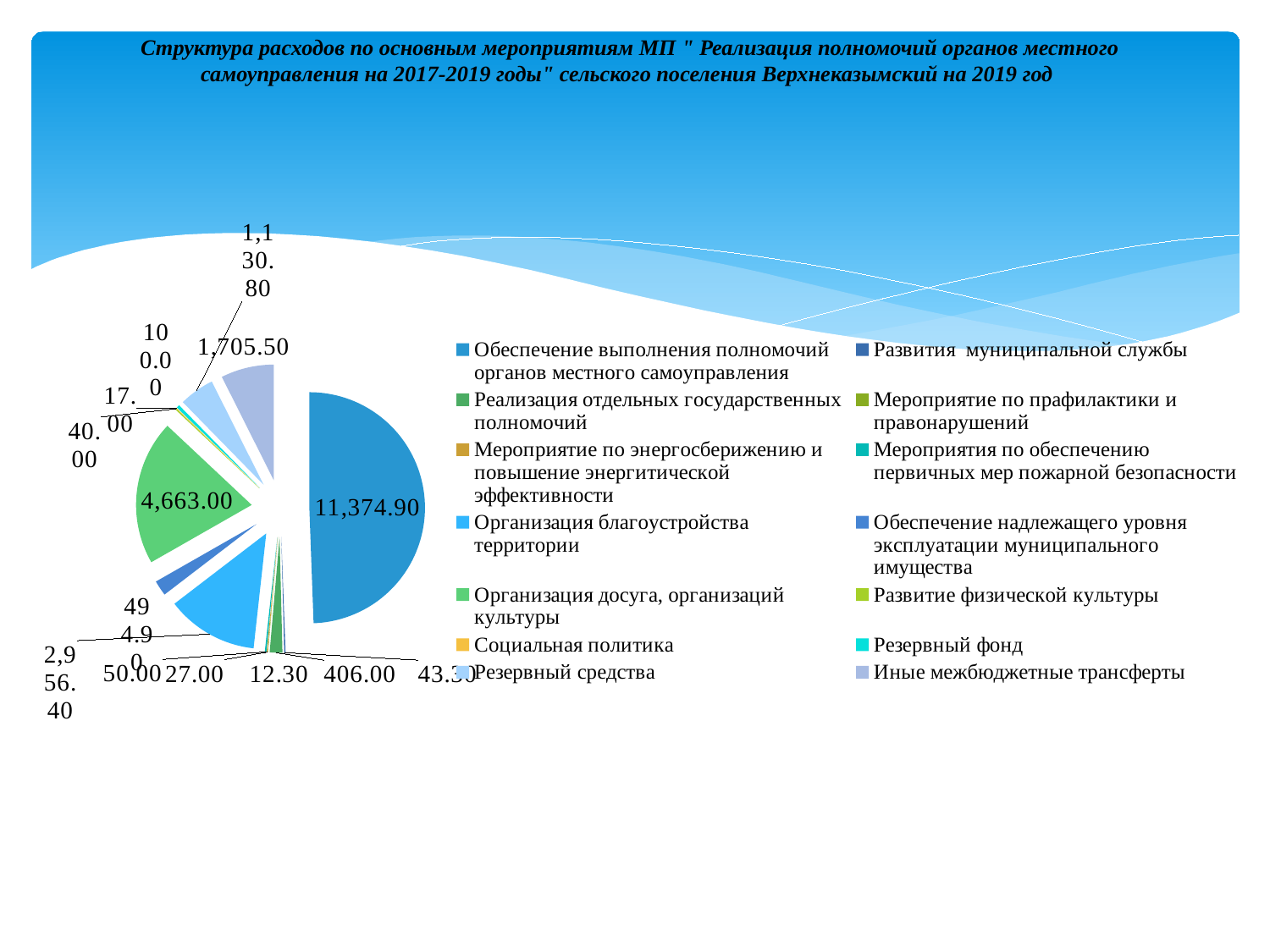
Which is larger: the slice labelled 1,705.50 or the slice labelled 1,130.80? 1,705.50 What kind of chart is shown on the slide? pie chart How many entries does the legend of the pie chart list? 14 What is the value labelled for 'Иные межбюджетные трансферты'? 1,705.50 What is the value labelled for 'Организация благоустройства территории'? 2,956.40 What is the value of the largest slice of the pie chart? 11,374.90 What is the smallest value labelled on the pie chart? 12.30 Which category has the largest slice in the pie chart? Обеспечение выполнения полномочий органов местного самоуправления For which year does the slide title say the expenditure structure is shown? 2019 What is the difference between the largest slice (11,374.90) and the slice labelled 4,663.00? 6,711.90 What is the value labelled on the green slice for 'Организация досуга, организаций культуры'? 4,663.00 How many slices does the pie chart have? 14